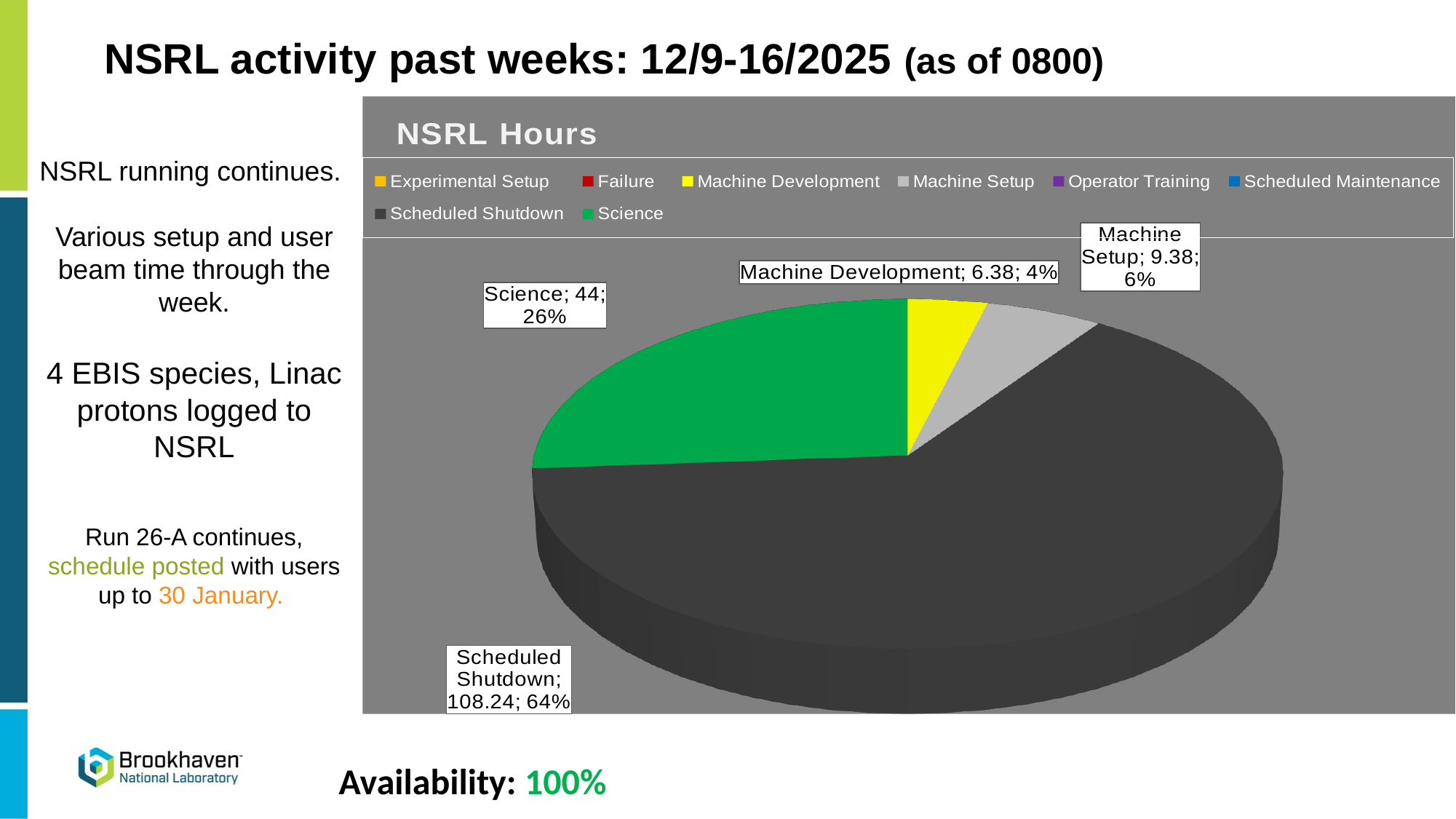
How many entries does the chart legend list? 8 How many hours are labeled for Science? 44 Which labeled category has the largest slice of the pie? Scheduled Shutdown What percentage share of the pie does Scheduled Shutdown have? 64% What type of chart is shown on the slide? pie chart What is the title of the chart? NSRL Hours How many hours are labeled for Scheduled Shutdown? 108.24 Which has more hours, Science or Machine Setup? Science Which labeled category has the smallest slice of the pie? Machine Development How many hours are labeled for Machine Setup? 9.38 What is the difference in hours between Machine Setup and Machine Development? 3 What percentage share of the pie does Machine Development have? 4%